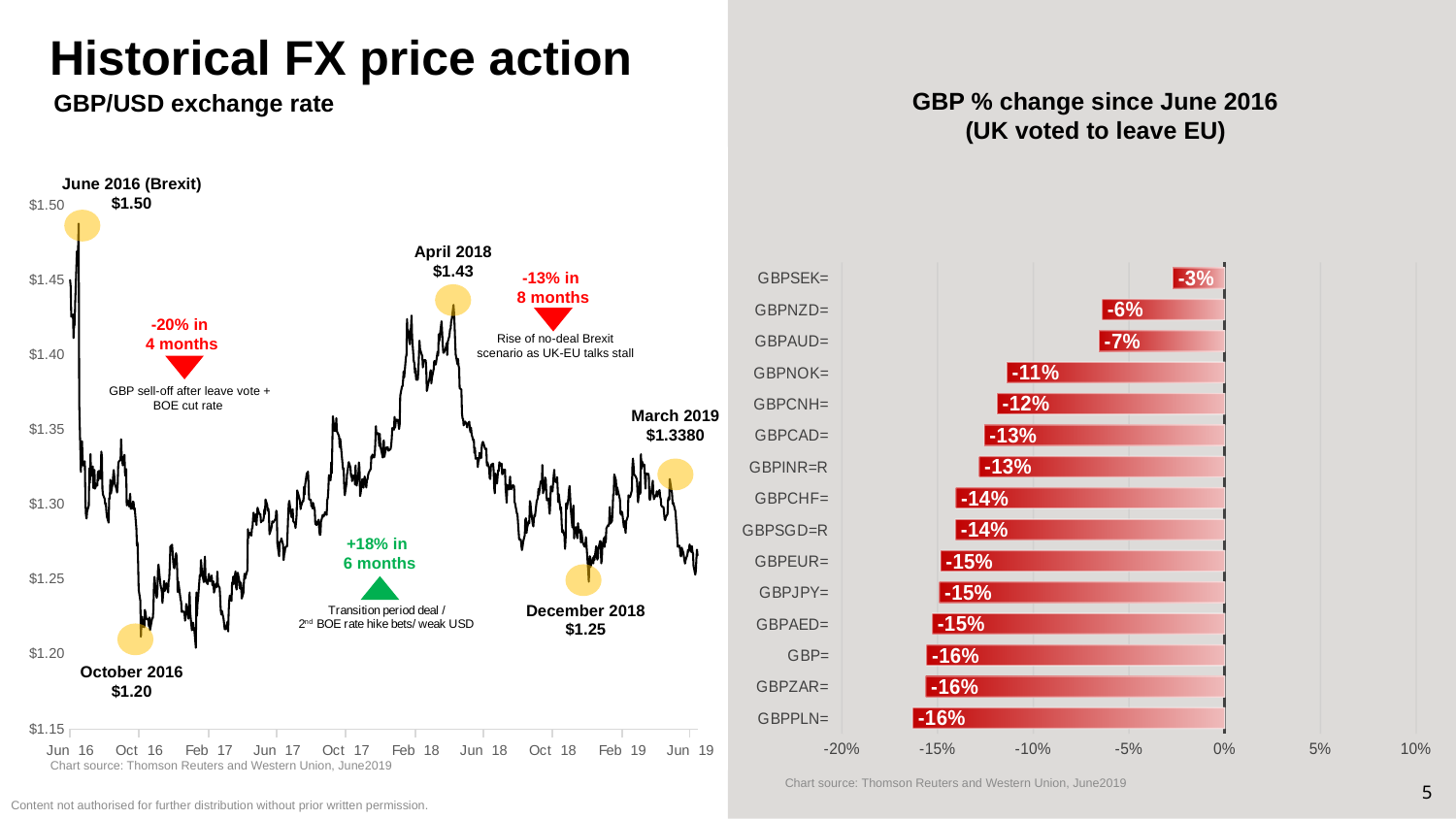
How many categories are shown on the 'GBP % change since June 2016' chart? 15 On the 'GBP % change since June 2016' chart, which has the larger decline, GBPNZD= or GBPCNH=? GBPCNH= On the 'GBP/USD exchange rate' chart, what value is labelled for March 2019? $1.3380 On the 'GBP % change since June 2016' chart, which category has the smallest decline (value closest to zero)? GBPSEK= On the 'GBP % change since June 2016' chart, what is the value for GBPEUR=? -15% On the 'GBP % change since June 2016' chart, what is the difference between the values for GBPSEK= and GBPPLN=? 13 percentage points On the 'GBP % change since June 2016' chart, what is the value for GBPNOK=? -11% What kind of chart is the 'GBP % change since June 2016' chart? Bar chart On the 'GBP/USD exchange rate' chart, what is the difference between the labelled values for April 2018 and December 2018? $0.18 What kind of chart is the 'GBP/USD exchange rate' chart? Line chart On the 'GBP % change since June 2016' chart, what is the value for GBPSEK=? -3% On the 'GBP/USD exchange rate' chart, what value is labelled for June 2016 (Brexit)? $1.50